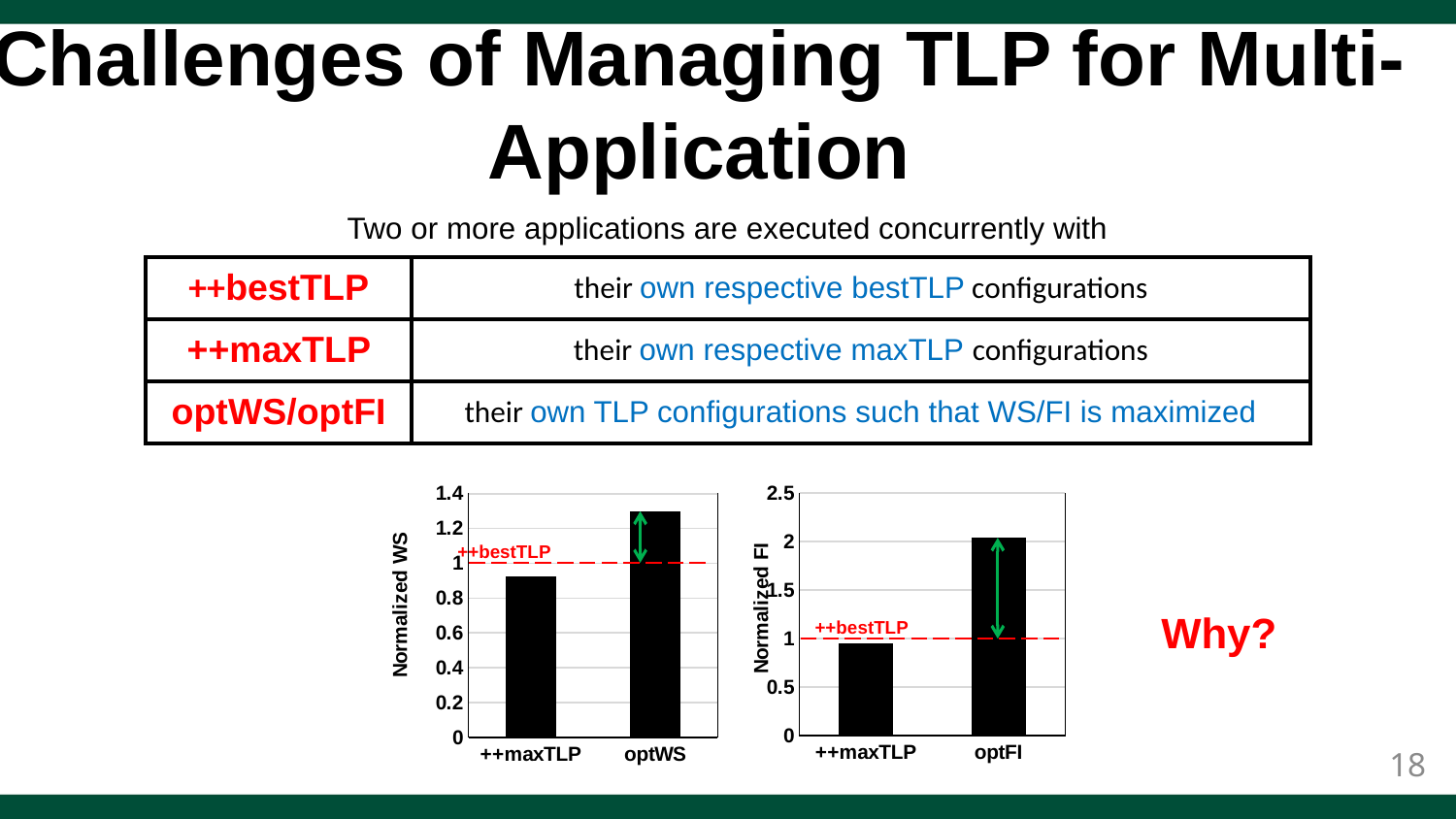
What label is written next to the red dashed line in the Normalized FI chart? ++bestTLP In the Normalized WS chart, which category has the higher bar? optWS What is the y-axis label of the left chart? Normalized WS How many categories are shown on the x axis of the Normalized WS chart? 2 In the Normalized FI chart, is the value for ++maxTLP greater or less than 1.5? less In the Normalized WS chart, is the value for ++maxTLP greater or less than 1? less What kind of chart is the Normalized FI chart? bar chart In the Normalized WS chart, is the value for optWS greater or less than 1.2? greater In the Normalized FI chart, which category has the higher bar? optFI In the Normalized WS chart, which category has the lower bar? ++maxTLP In the Normalized FI chart, which category has the lower bar? ++maxTLP